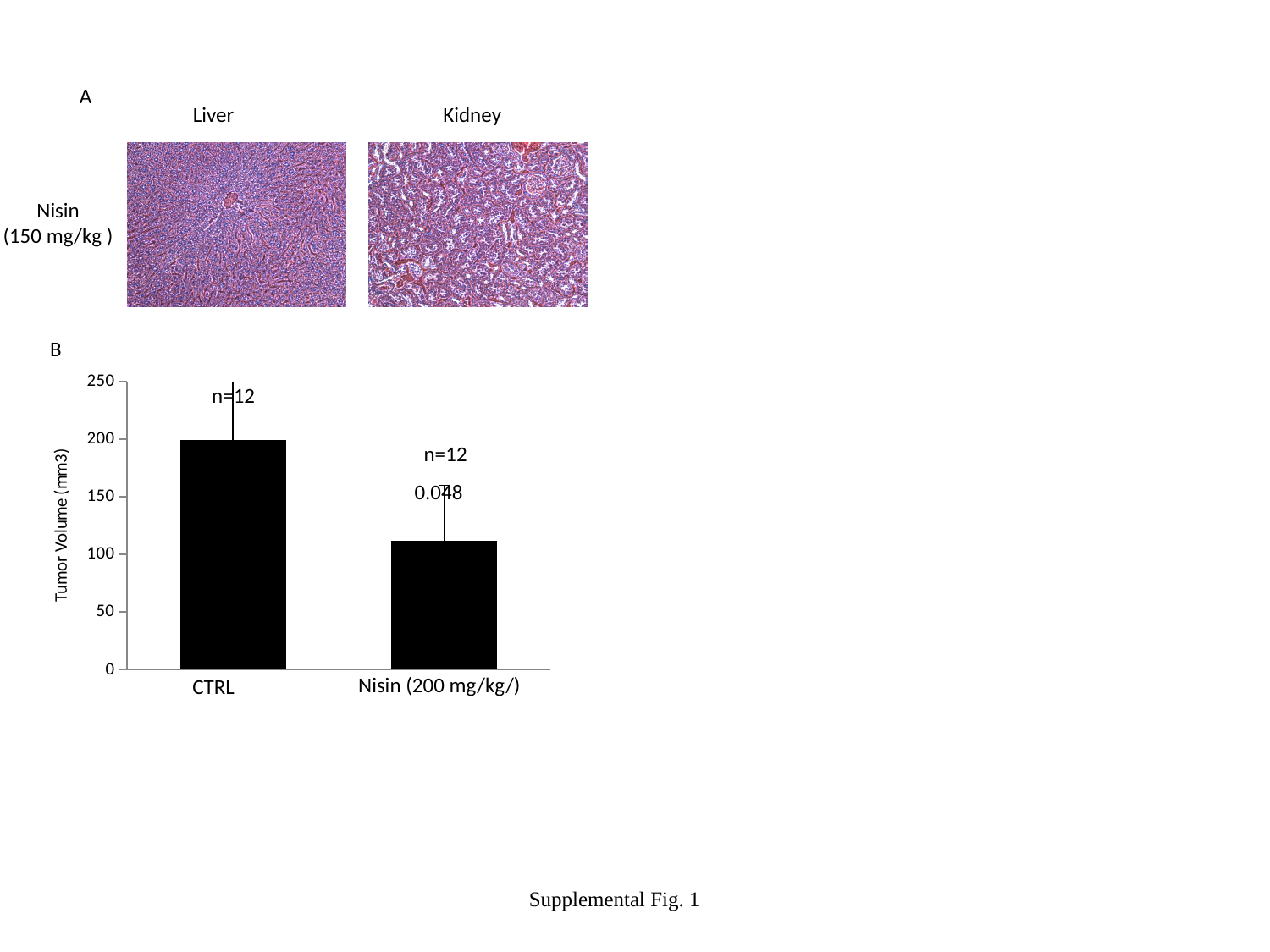
In the panel B chart, is the tumor volume for CTRL greater or less than 150? greater In the panel B chart, do the tumor volumes rise or fall from CTRL to Nisin (200 mg/kg/)? fall What kind of chart is shown in panel B? bar chart In the panel B chart, is the tumor volume for CTRL greater or less than 250? less In the panel B chart, is the tumor volume for Nisin (200 mg/kg/) greater or less than 150? less How many bars are plotted in the panel B chart? 2 What is the y-axis label of the panel B chart? Tumor Volume (mm3) In the panel B chart, what sample size (n) is annotated above each bar? n=12 In the panel B chart, which is larger, the tumor volume for CTRL or for Nisin (200 mg/kg/)? CTRL In the panel B chart, which category has the highest tumor volume? CTRL In the panel B chart, which category has the lowest tumor volume? Nisin (200 mg/kg/)